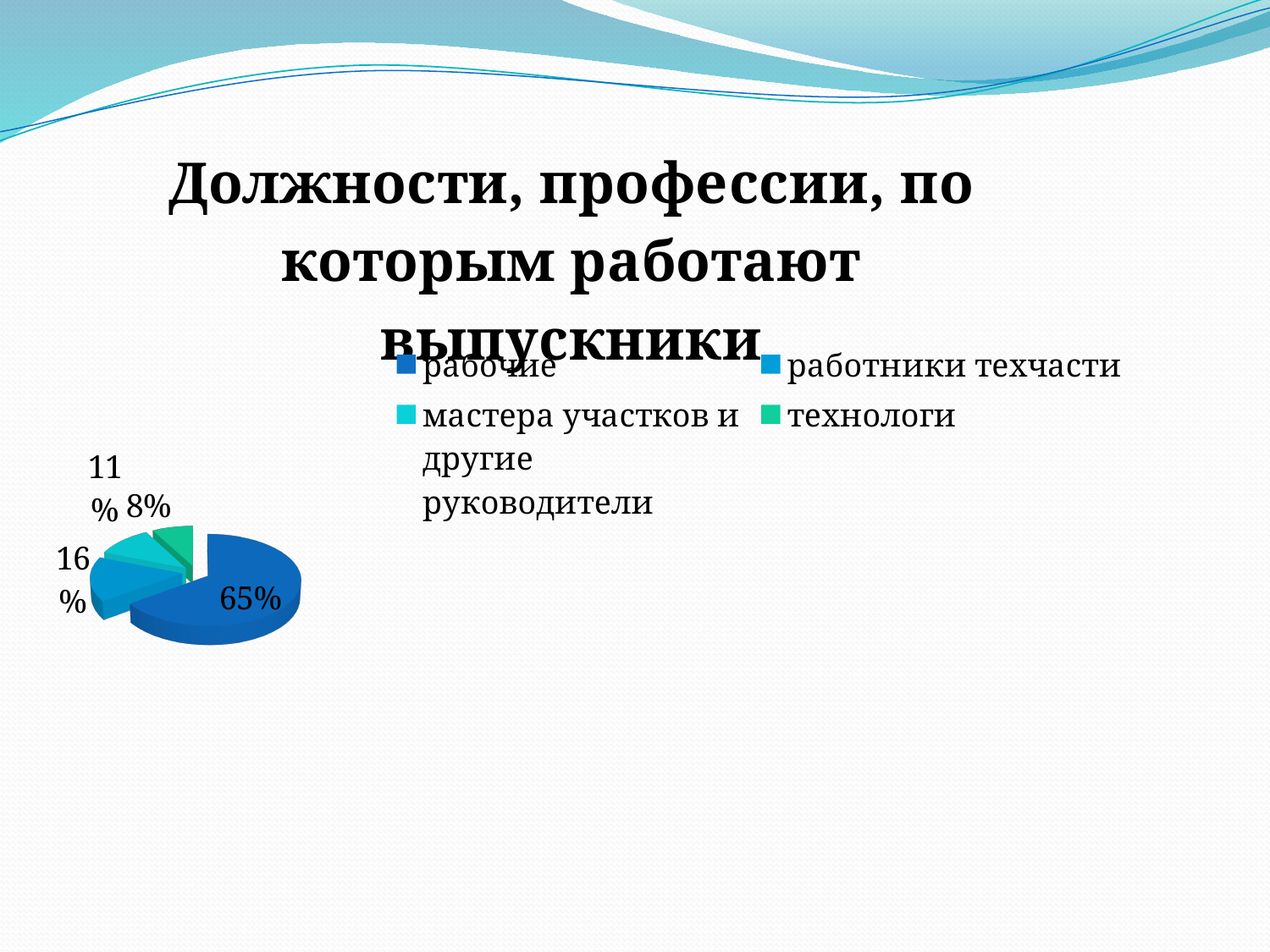
What share of the pie does the 'работники техчасти' slice have? 16% What share of the pie does the 'мастера участков и другие руководители' slice have? 11% What is the difference in percentage points between the 'рабочие' slice and the 'работники техчасти' slice? 49 How many slices does the pie chart have? 4 What share of the pie does the 'рабочие' slice have? 65% Which category has the largest slice of the pie? рабочие Which slice is larger: 'мастера участков и другие руководители' or 'технологи'? мастера участков и другие руководители Which category has the smallest slice of the pie? технологи What share of the pie does the 'технологи' slice have? 8% How many entries does the legend list? 4 What is the title of the chart on the slide? Должности, профессии, по которым работают выпускники What kind of chart is shown on the slide? pie chart